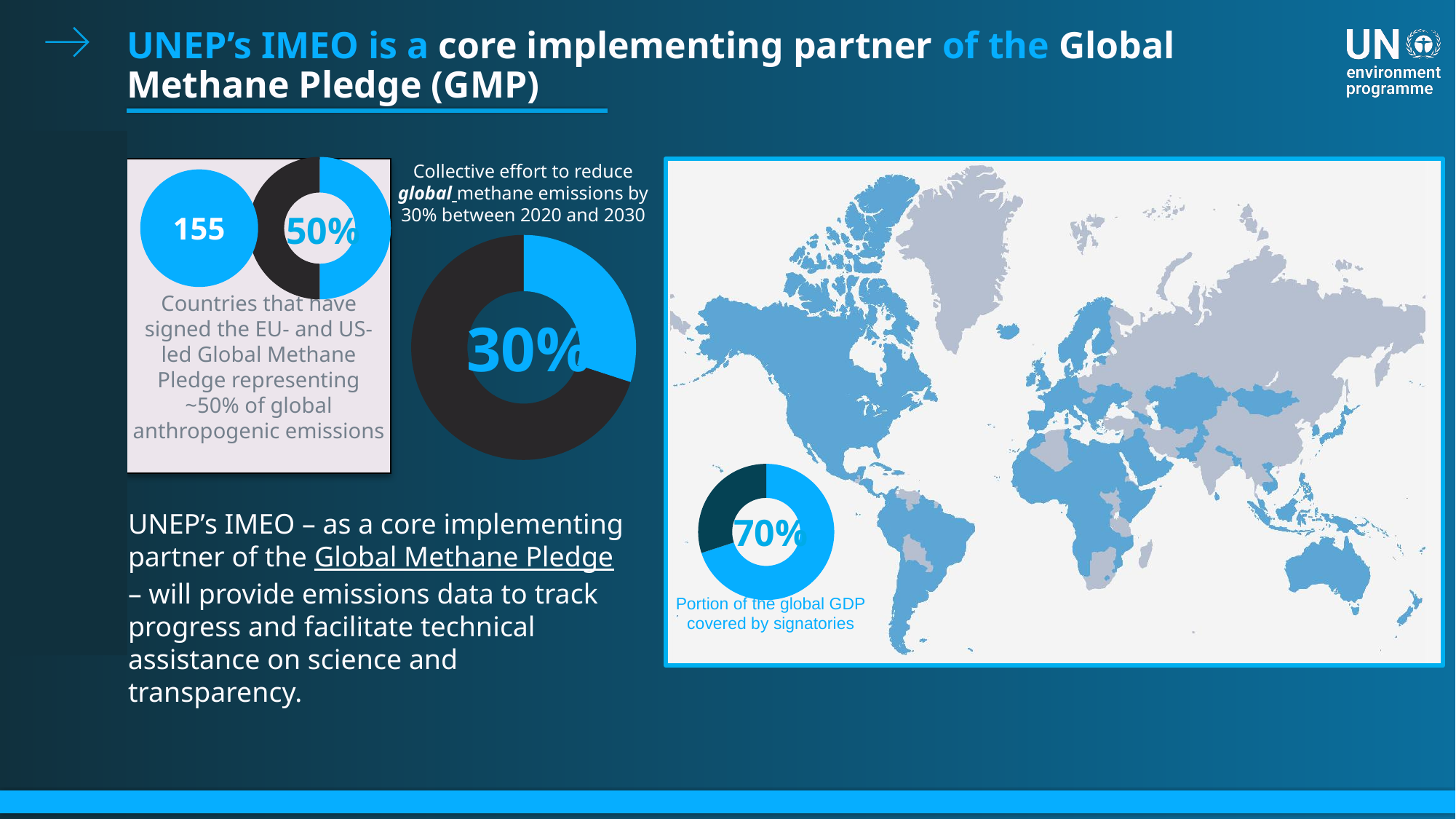
What does the 70% donut chart on the world map represent, according to its caption? Portion of the global GDP covered by signatories On the donut chart inside the world map, what percentage is printed in the centre? 70% What number is printed in the blue circle next to the 50% donut chart in the top-left panel? 155 Which is larger: the percentage on the donut chart in the world map or the percentage on the 'Collective effort to reduce global methane emissions' donut chart? The donut chart in the world map (70%) On the 'Collective effort to reduce global methane emissions' donut chart, what share of the ring is the dark (non-blue) portion? 70% Which of the three donut charts on the slide shows the lowest percentage? The 'Collective effort to reduce global methane emissions' chart (30%) On the world-map donut chart, what share of the ring is the dark (non-blue) portion? 30% On the donut chart labelled 'Collective effort to reduce global methane emissions by 30% between 2020 and 2030', what percentage is printed in the centre? 30% What kind of chart is used to show the 30% methane reduction target? Donut (pie) chart What is the difference between the percentage shown on the world-map donut chart and the percentage shown on the methane reduction donut chart? 40 percentage points On the donut chart in the top-left panel about countries that have signed the Global Methane Pledge, what percentage is printed in the centre? 50% How many donut charts are shown on the slide? 3